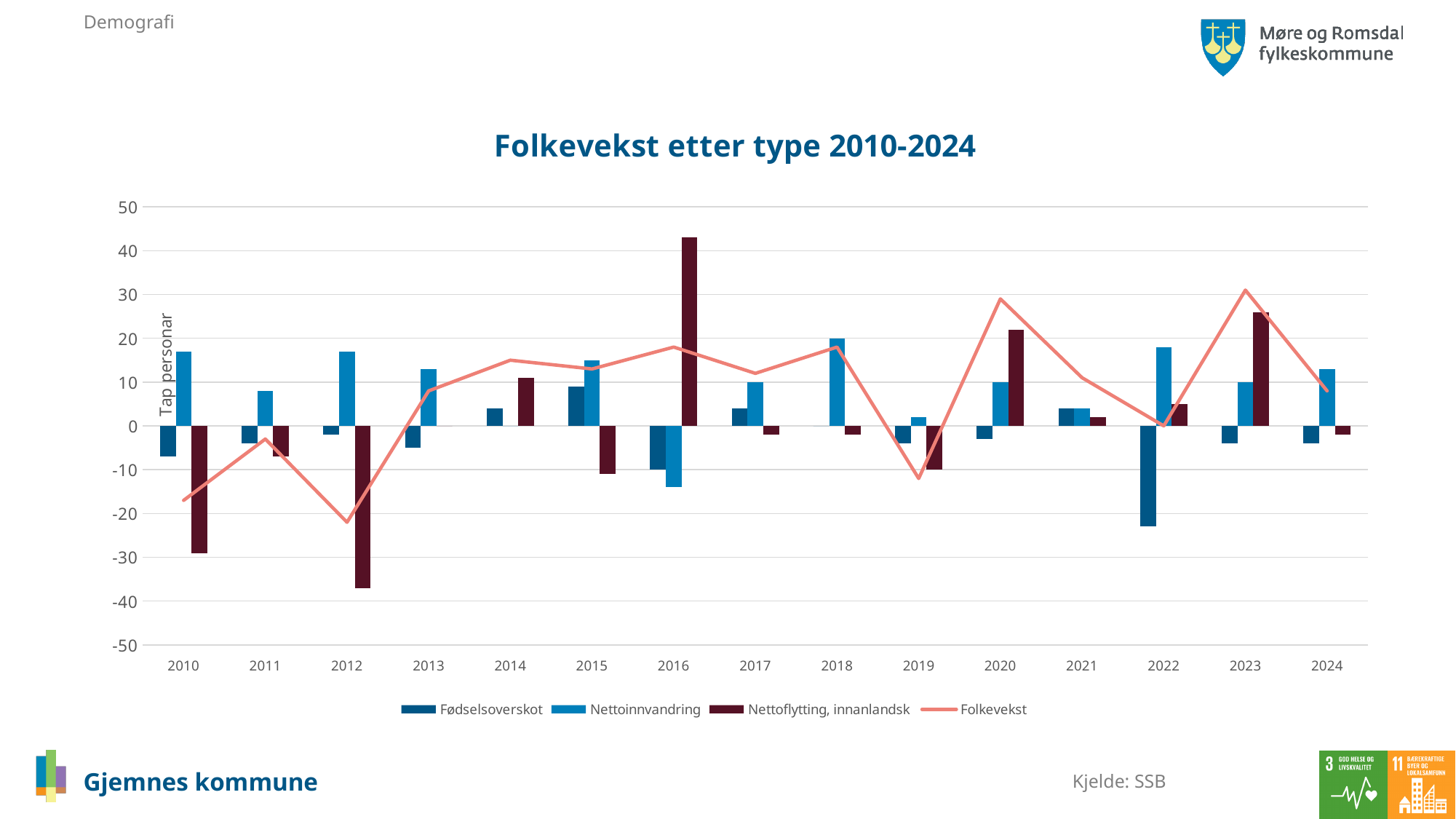
In which year is Nettoflytting, innanlandsk highest? 2016 Is the value for Fødselsoverskot in 2022 greater or less than -20? less How many years are shown on the x axis? 15 Is the value for Nettoflytting, innanlandsk in 2016 greater or less than 40? greater In which year is Fødselsoverskot lowest? 2022 In which year is Nettoflytting, innanlandsk lowest? 2012 Is the value for Folkevekst in 2012 greater or less than -20? less Which is larger, Nettoinnvandring in 2010 or Nettoinnvandring in 2011? 2010 What is the title of the chart? Folkevekst etter type 2010-2024 How many series does the legend list? 4 What kind of chart is shown on the slide? Combined bar and line chart